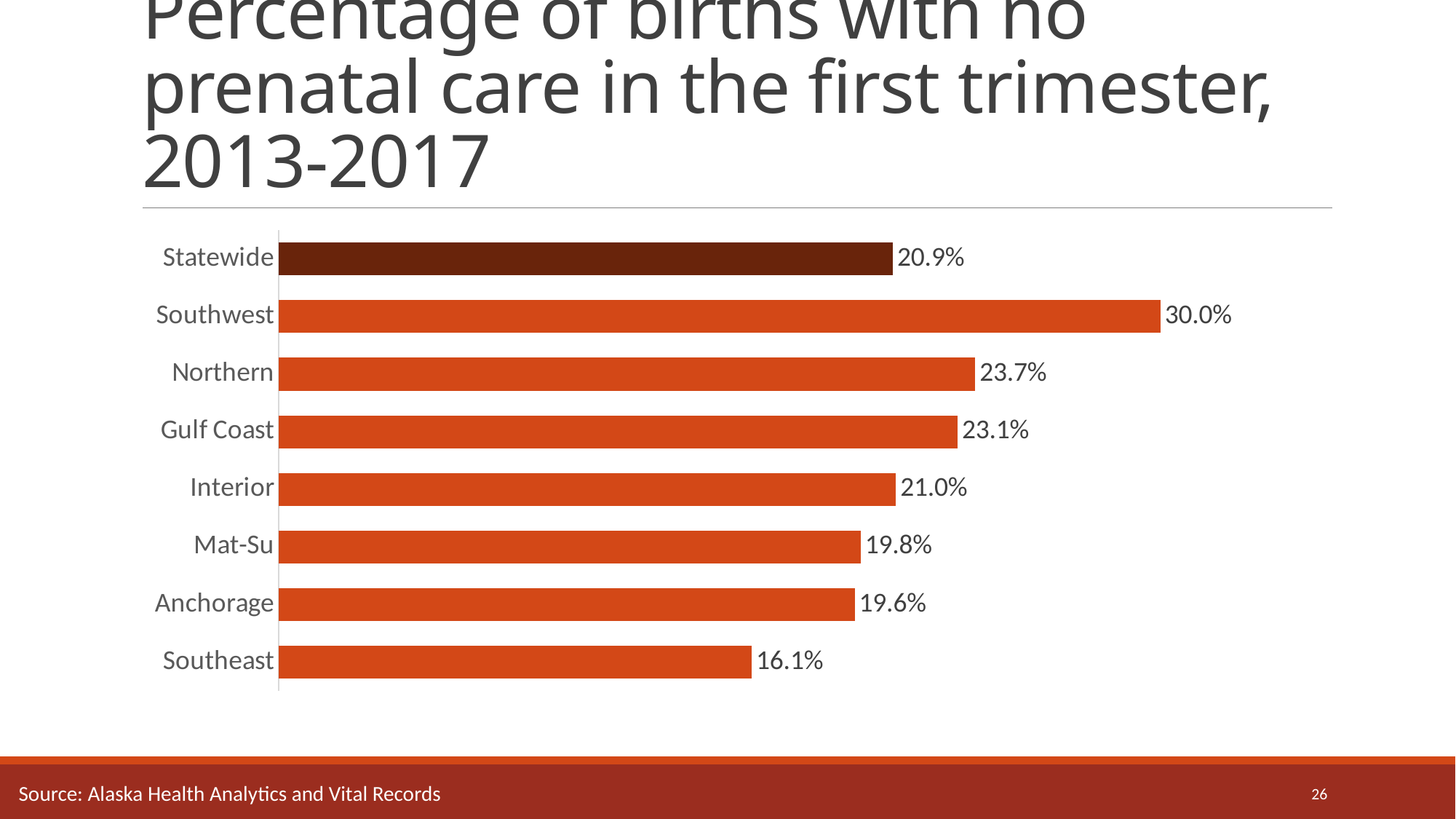
What is the value for Southwest? 30.0% Which bar is shown in a darker colour than the others? Statewide Which is larger, the value for Interior or the value for Southeast? Interior What is the difference between the values for Southwest and Southeast? 13.9% What is the value for Statewide? 20.9% How many categories are shown in the chart? 8 What is the value for Anchorage? 19.6% What is the value for Gulf Coast? 23.1% Which category has the lowest value? Southeast What is the difference between the values for Northern and Statewide? 2.8% What kind of chart is shown on the slide? Bar chart Which region has the highest percentage of births with no prenatal care in the first trimester? Southwest